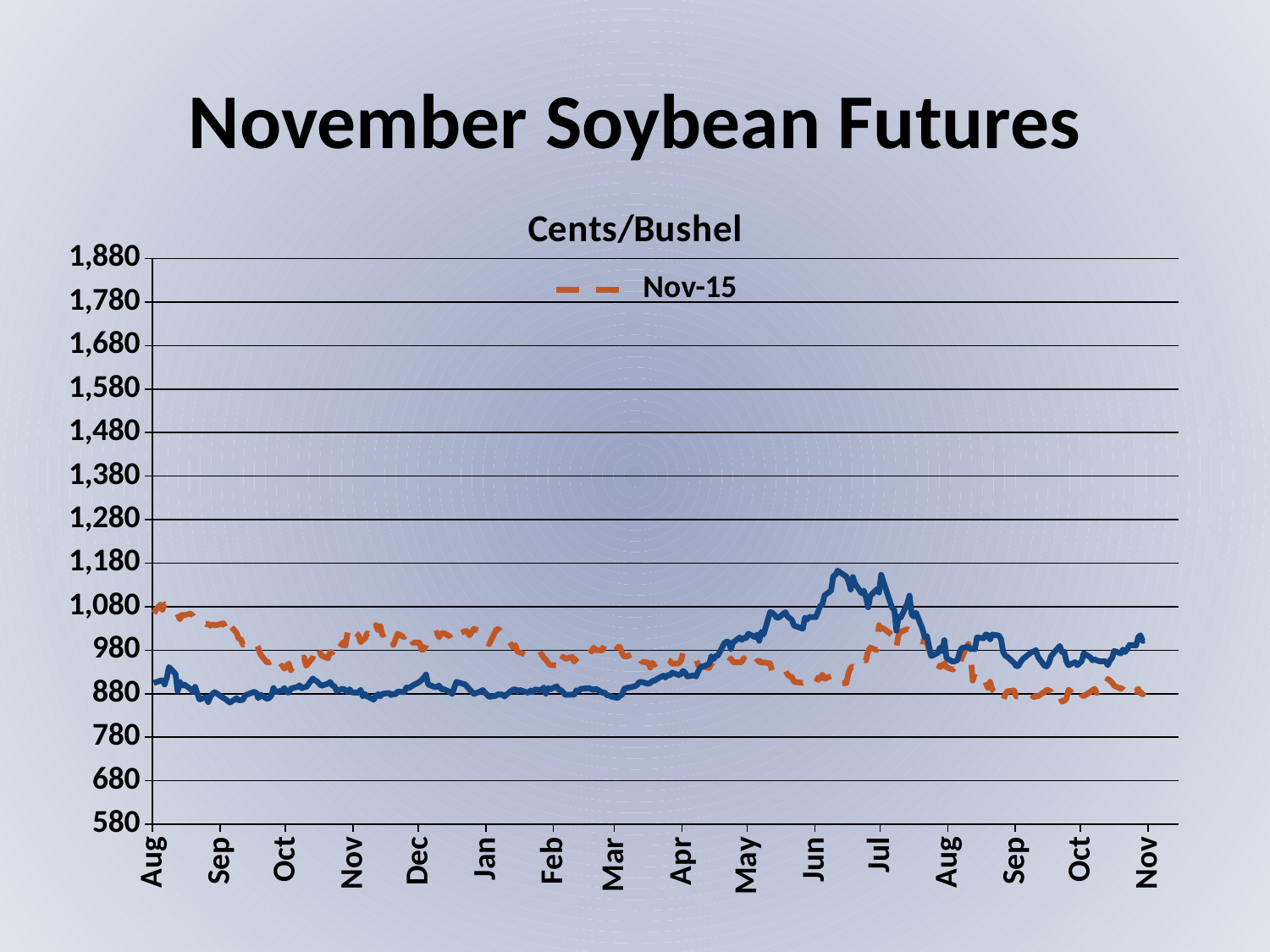
Does the Nov-15 line rise or fall from the first Aug label to the first Sep label? fall How many series does the chart legend list? 1 What is the highest value shown on the y axis? 1,880 Is the Nov-15 value at the Jan label greater or less than 980? greater Does the Nov-15 line rise or fall from the Jul label to the second Sep label? fall Is the Nov-15 value at the second Sep label greater or less than 980? less Is the Nov-15 value at the May label greater or less than 1,080? less What is the title shown above the chart's plot area? Cents/Bushel How many month labels are shown along the x axis? 16 What series name does the chart legend list? Nov-15 What kind of chart is shown on the slide? line chart